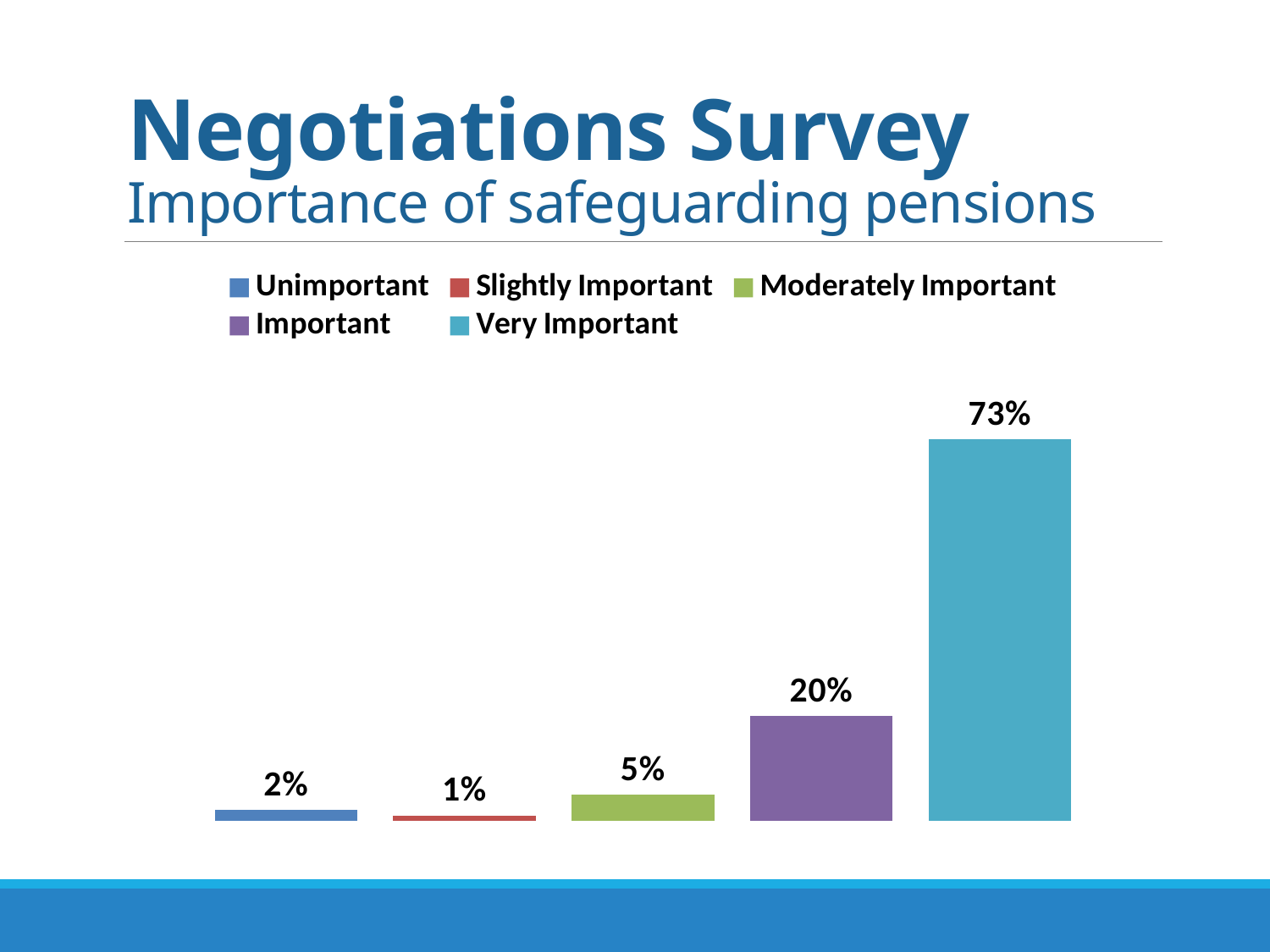
What percentage of respondents rated safeguarding pensions as Very Important? 73% What colour is the bar for Slightly Important? Red What type of chart is shown on the slide? Bar chart How many entries does the legend list? 5 How many response categories are shown in the chart? 5 What percentage of respondents rated safeguarding pensions as Important? 20% What percentage of respondents rated safeguarding pensions as Unimportant? 2% What is the difference in percentage points between Very Important and Important? 53 Which response category has the lowest percentage? Slightly Important Which is larger, the percentage for Moderately Important or for Unimportant? Moderately Important Which response category has the highest percentage? Very Important What percentage of respondents rated safeguarding pensions as Moderately Important? 5%